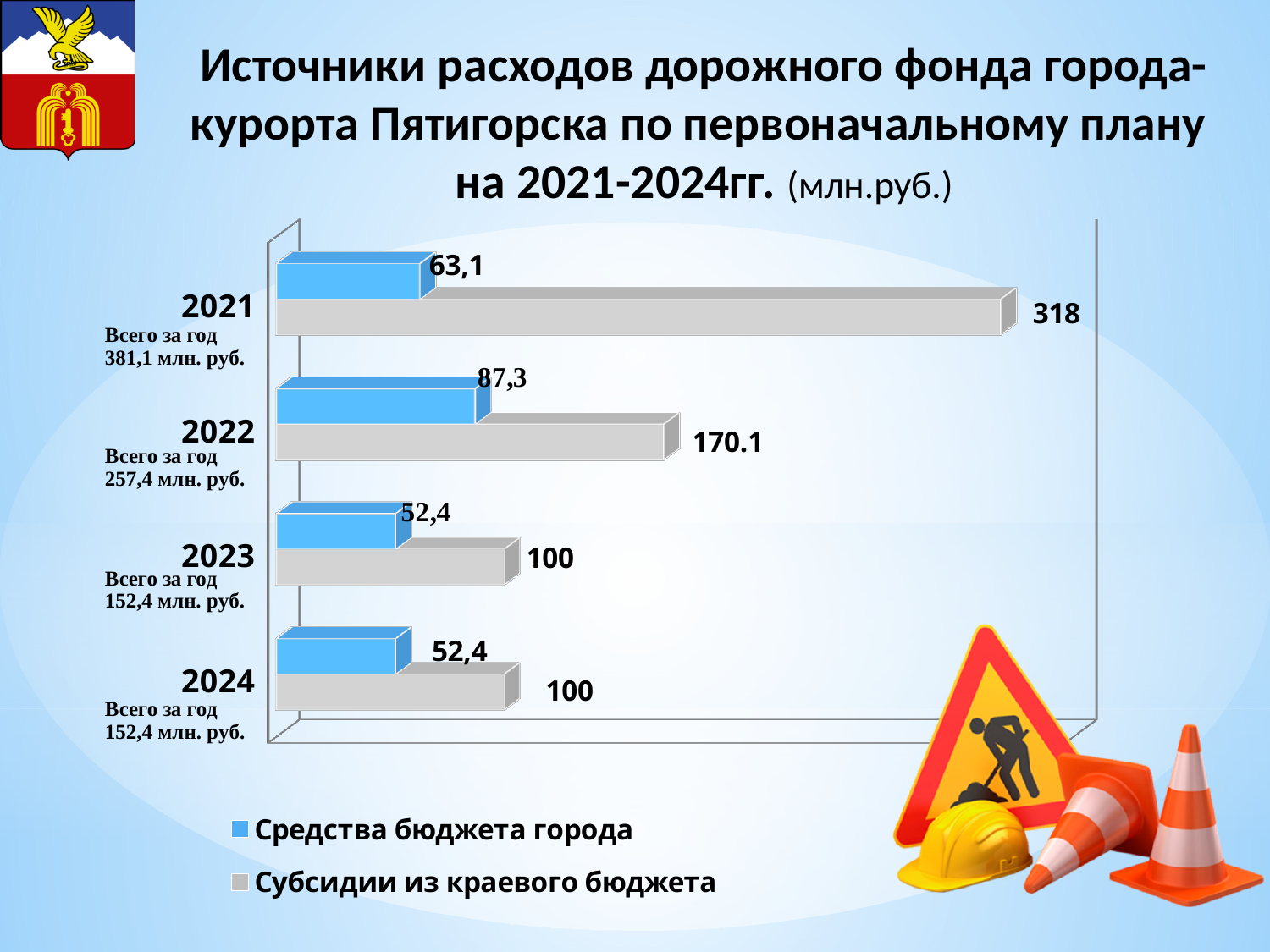
How many years (categories) are shown on the chart? 4 What is the value of 'Средства бюджета города' for 2021? 63,1 What type of chart is shown on the slide? bar chart Which colour represents 'Субсидии из краевого бюджета' in the legend? grey What is the value of 'Средства бюджета города' for 2022? 87,3 What is the total for the year 2022 as printed on the slide? 257,4 млн. руб. In which year is 'Средства бюджета города' the highest? 2022 What is the value of 'Субсидии из краевого бюджета' for 2022? 170.1 What is the difference between 'Субсидии из краевого бюджета' in 2021 and in 2022? 147,9 Which is larger in 2023: 'Средства бюджета города' or 'Субсидии из краевого бюджета'? Субсидии из краевого бюджета In which year is 'Субсидии из краевого бюджета' the highest? 2021 How many series does the legend list? 2